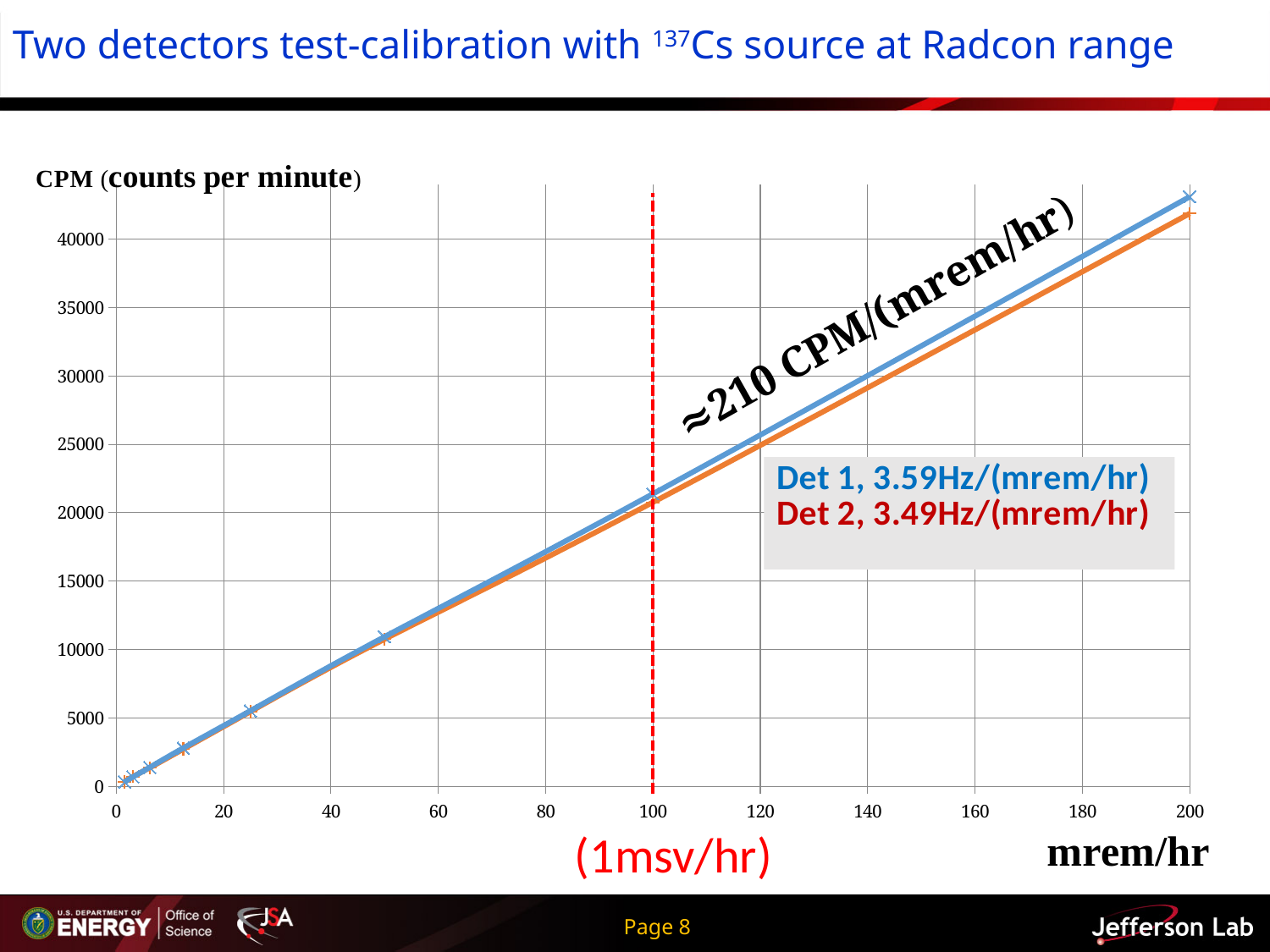
At 200 mrem/hr, which detector shows the higher CPM, Det 1 or Det 2? Det 1 How many detector series are plotted on the chart? 2 Is the CPM value for Det 2 at 100 mrem/hr greater or less than 25000? less What unit is shown on the x axis of the chart? mrem/hr What sensitivity is given for Det 2 on the chart? 3.49Hz/(mrem/hr) Do the CPM values rise or fall as the dose rate in mrem/hr increases? rise What approximate slope is annotated on the chart? ≈210 CPM/(mrem/hr) Is the CPM value for Det 2 at 50 mrem/hr greater or less than 15000? less Is the CPM value for Det 1 at 100 mrem/hr greater or less than 20000? greater What sensitivity is given for Det 1 on the chart? 3.59Hz/(mrem/hr) What kind of chart is shown on the slide? line chart